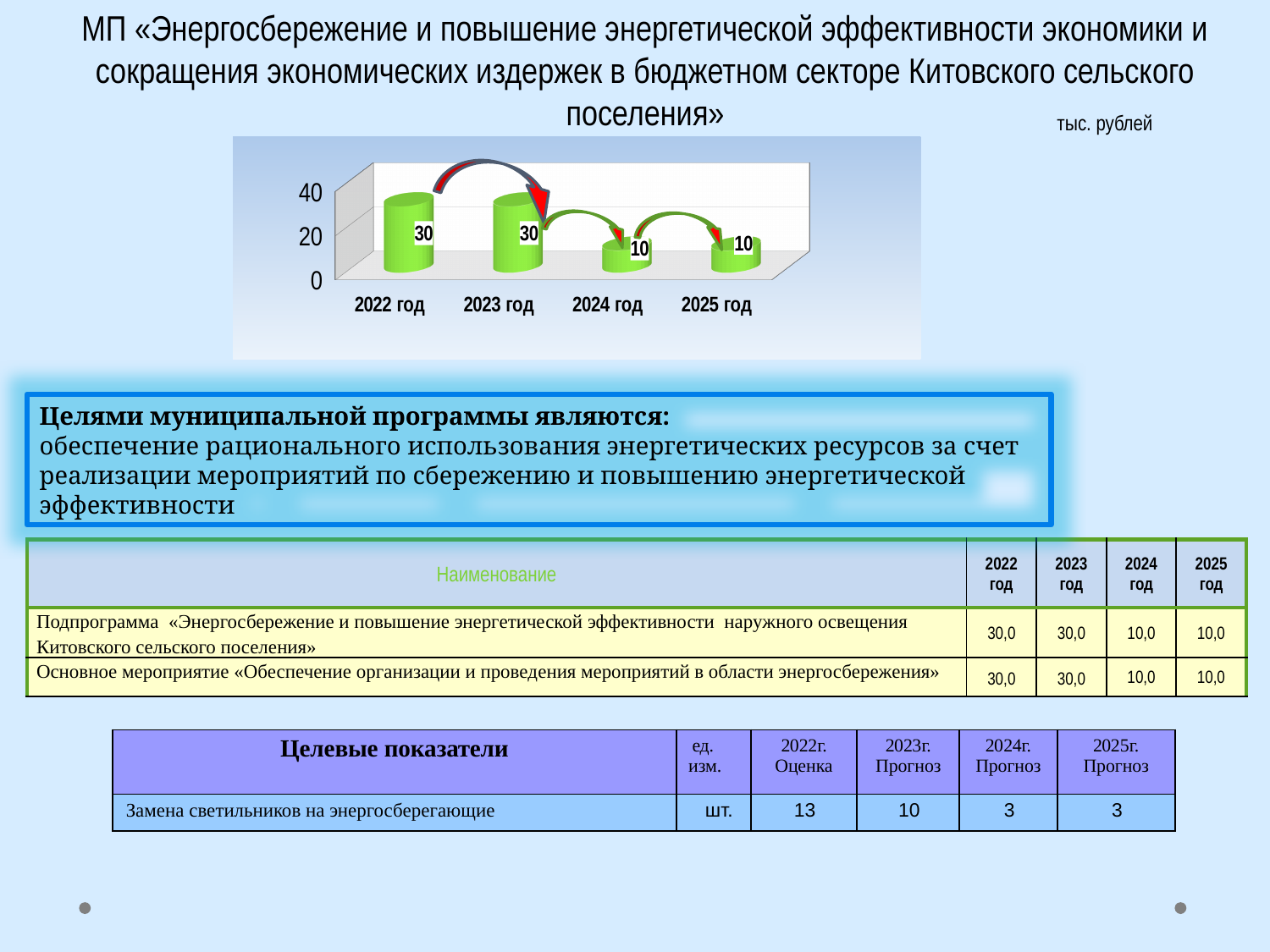
What is the value for 2025 год in the chart? 10 What is the value for 2023 год in the chart? 30 What is the value for 2024 год in the chart? 10 What kind of chart is shown on the slide? bar chart What is the difference between the values for 2023 год and 2024 год in the chart? 20 How many categories (years) are shown on the x axis of the chart? 4 What unit is indicated for the chart values on the slide? тыс. рублей Which is larger in the chart, the value for 2022 год or the value for 2024 год? 2022 год Is the value for 2025 год greater or less than 20? less Do the values in the chart rise or fall from 2022 год to 2025 год? fall Is the value for 2022 год greater or less than 20? greater What is the value for 2022 год in the chart? 30